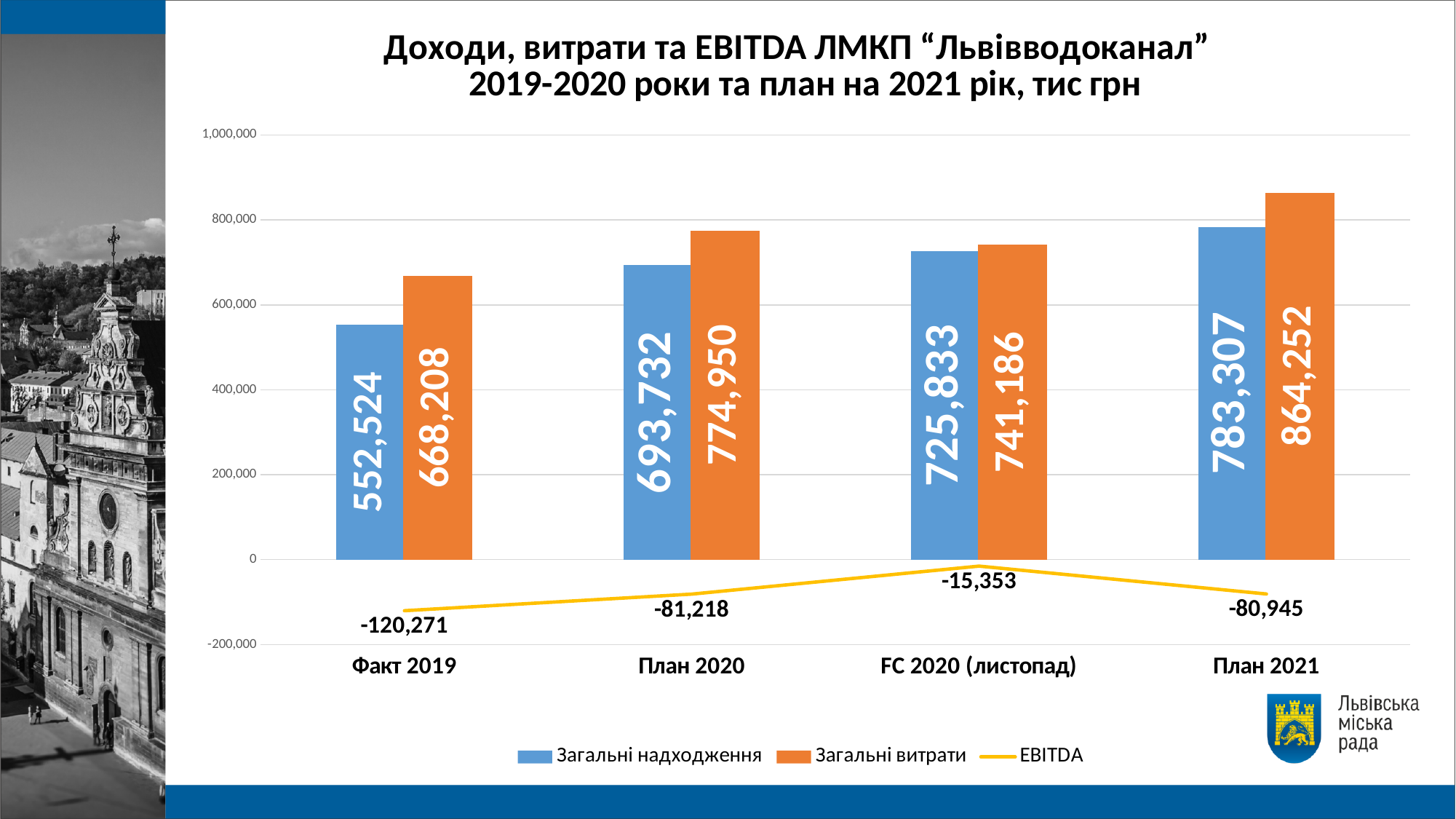
What kind of chart is shown on the slide? Bar and line chart What is the difference between Загальні витрати and Загальні надходження for Факт 2019? 115,684 Which category has the lowest EBITDA? Факт 2019 Do the Загальні надходження values rise or fall from Факт 2019 to План 2021? Rise What is the EBITDA value for FC 2020 (листопад)? -15,353 Which is larger for FC 2020 (листопад): Загальні надходження or Загальні витрати? Загальні витрати How many categories are shown on the x axis? 4 Which category has the highest Загальні надходження? План 2021 What is the value of Загальні надходження for Факт 2019? 552,524 What is the value of Загальні витрати for План 2021? 864,252 How many series does the legend list? 3 What is the value of Загальні витрати for План 2020? 774,950